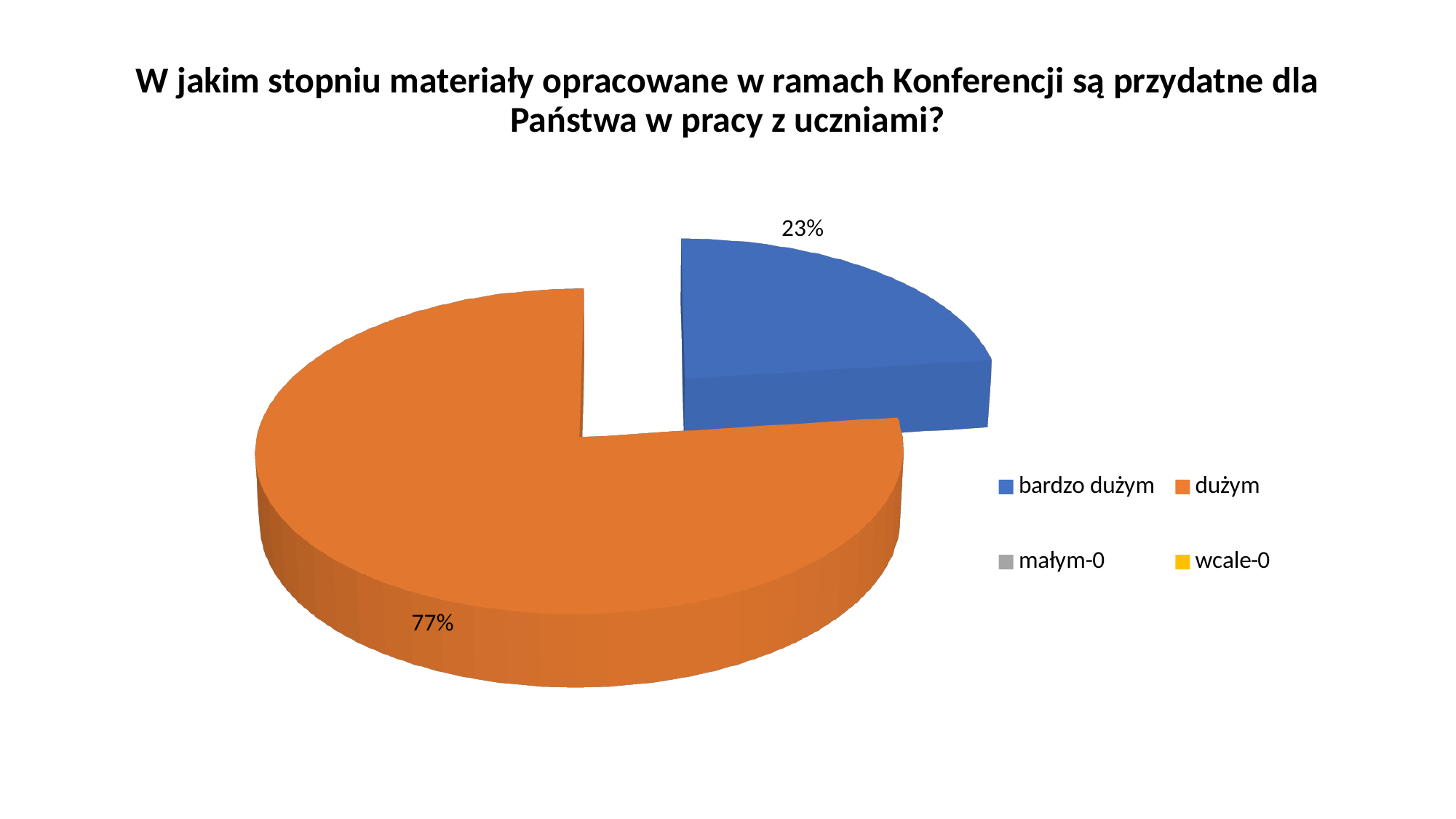
What value is shown in the legend for "wcale"? 0 What kind of chart is shown on the slide? pie chart Which category has the largest slice of the pie? dużym What colour is the slice for "bardzo dużym"? blue What is the title of the chart? W jakim stopniu materiały opracowane w ramach Konferencji są przydatne dla Państwa w pracy z uczniami? How many entries does the legend list? 4 Which of the two plotted slices is smaller, "bardzo dużym" or "dużym"? bardzo dużym What share of the pie does "bardzo dużym" represent? 23% Which is larger, the share for "bardzo dużym" or the share for "dużym"? dużym What is the difference in percentage points between the "dużym" and "bardzo dużym" slices? 54 What share of the pie does "dużym" represent? 77% What value is shown in the legend for "małym"? 0